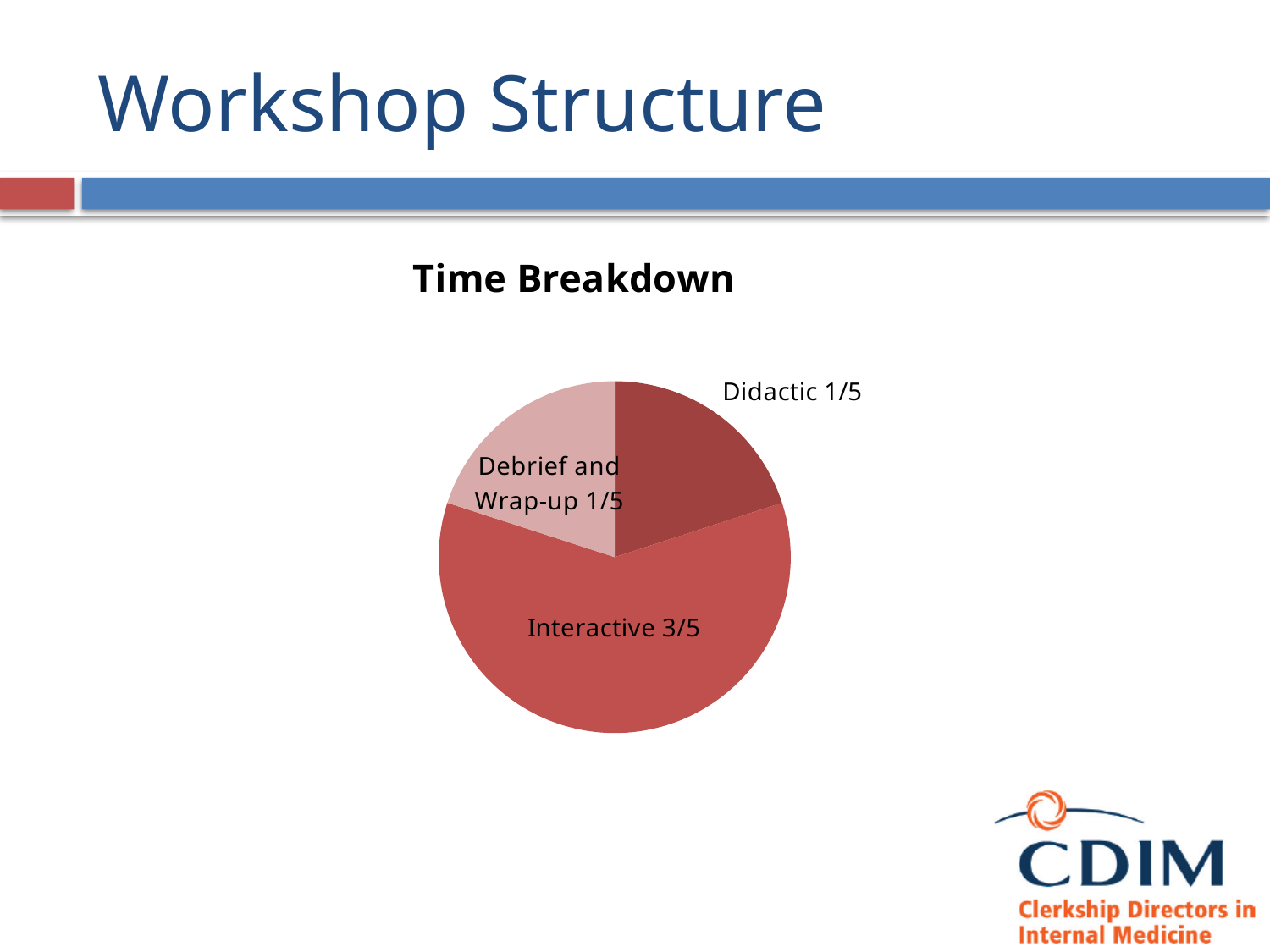
What is the title of the chart? Time Breakdown What is the combined share of the Didactic and Debrief and Wrap-up slices? 2/5 Which is larger, the Interactive slice or the Didactic slice? Interactive What share of the pie does the Didactic slice represent? 1/5 What share of the pie does the Interactive slice represent? 3/5 Which slice is shown in the lightest shade of pink? Debrief and Wrap-up What is the difference between the Interactive share and the Didactic share? 2/5 What share of the pie does the Debrief and Wrap-up slice represent? 1/5 Which slice of the pie chart is the largest? Interactive What kind of chart is shown on the slide? pie chart How many slices does the pie chart have? 3